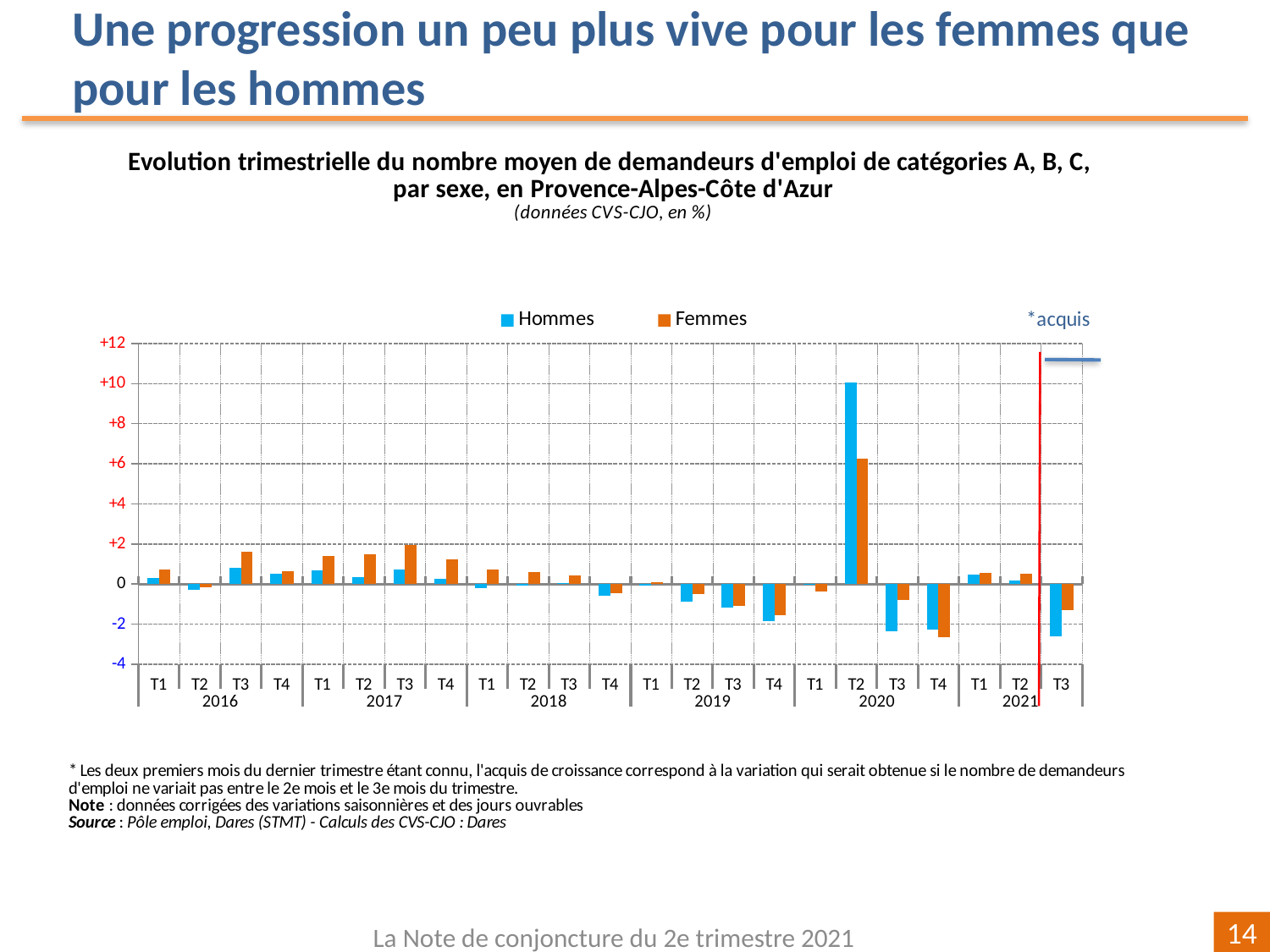
Which colour represents the Femmes series? orange In which quarter does the Hommes series reach its highest value? T2 2020 Is the value for Hommes in T3 2021 greater or less than -2? less What kind of chart is shown on the slide? bar chart In T3 2016, which series has the larger value, Hommes or Femmes? Femmes In T2 2020, which series has the larger value, Hommes or Femmes? Hommes Is the value for Femmes in T2 2020 greater or less than +4? greater What are the two series named in the legend? Hommes and Femmes How many series does the legend list? 2 How many quarters are plotted along the x axis? 23 In which quarter does the Femmes series reach its highest value? T2 2020 Is the value for Hommes in T2 2020 greater or less than +8? greater